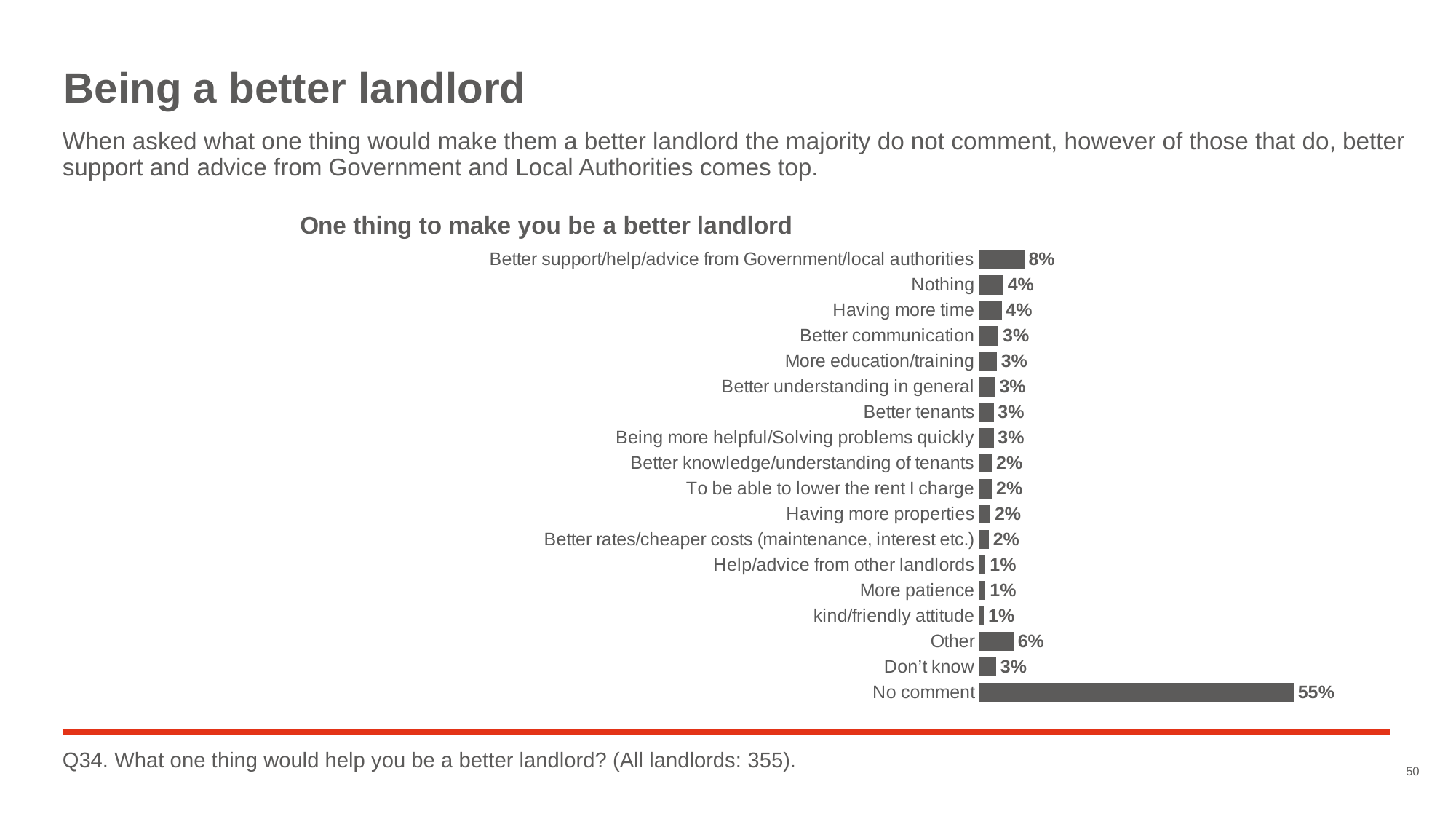
Which category has the highest value in the chart? No comment What is the difference between the values for 'Other' and 'Nothing'? 2% What is the value for 'Better support/help/advice from Government/local authorities'? 8% What is the difference between the values for 'No comment' and 'Better support/help/advice from Government/local authorities'? 47% What is the value for 'Having more time'? 4% What type of chart is shown on the slide? Bar chart How many categories are shown in the chart? 18 Which is larger, the value for 'Other' or the value for 'Don't know'? Other What percentage is shown for 'Other'? 6% What is the title of the chart? One thing to make you be a better landlord What percentage of landlords said 'No comment'? 55% Excluding 'No comment', 'Other' and 'Don't know', which specific suggestion has the highest value? Better support/help/advice from Government/local authorities